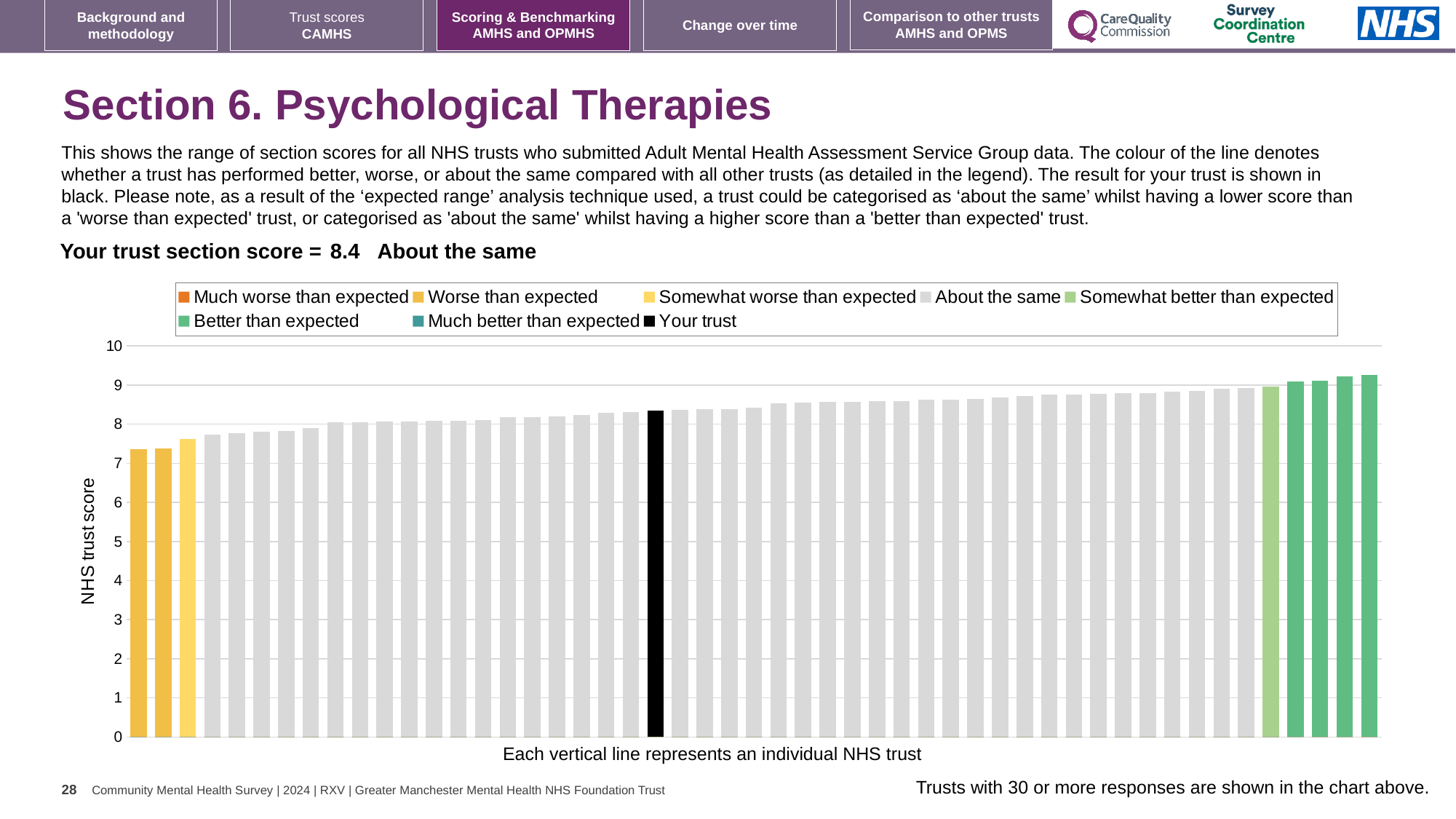
Is the value of the black 'Your trust' bar greater or less than 8? greater What is the section score for your trust shown on the slide? 8.4 Is the value of the lowest bar in the chart greater or less than 7? greater What is the label on the vertical axis of the chart? NHS trust score What kind of chart is shown on the slide? bar chart How many bars are coloured as 'Worse than expected' (dark yellow)? 2 How many entries does the chart legend list? 8 Is the value of the tallest bar in the chart greater or less than 9? greater Do the bar values rise or fall from left to right across the chart? rise How many bars are coloured as 'Better than expected' (green)? 4 Which legend category does the tallest bar in the chart belong to? Better than expected Which legend category does the shortest bar in the chart belong to? Worse than expected